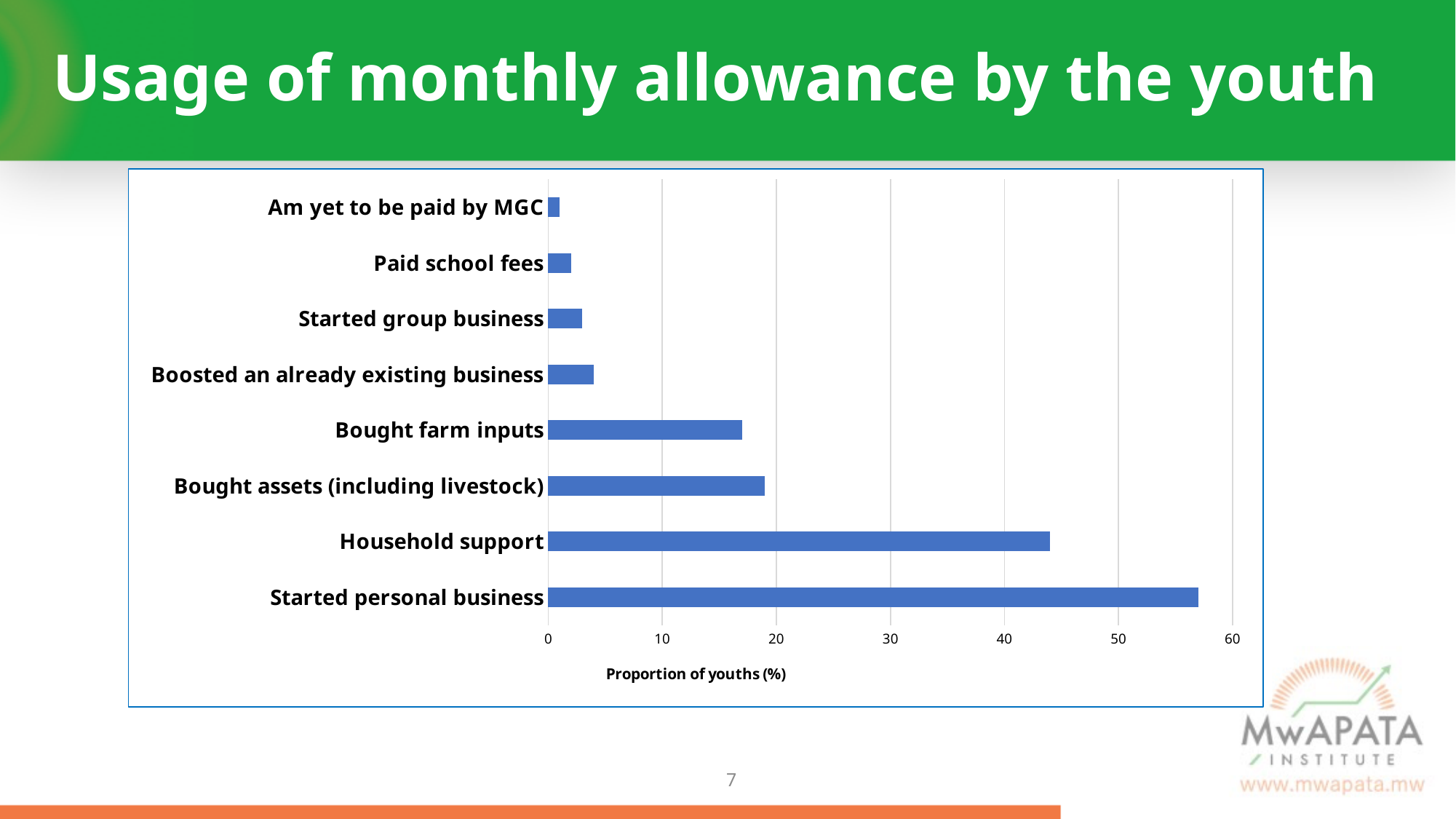
What kind of chart is shown on the slide? bar chart Which category has the lowest proportion of youths? Am yet to be paid by MGC Which is larger, the value for Started personal business or the value for Household support? Started personal business Which is larger, the value for Household support or the value for Bought assets (including livestock)? Household support Is the value for Boosted an already existing business greater or less than 10? less What colour are the bars in the chart? blue Is the value for Bought farm inputs greater or less than 20? less Is the value for Started personal business greater or less than 50? greater How many categories are plotted in the chart? 8 What is the label of the horizontal axis? Proportion of youths (%) Which category has the highest proportion of youths? Started personal business